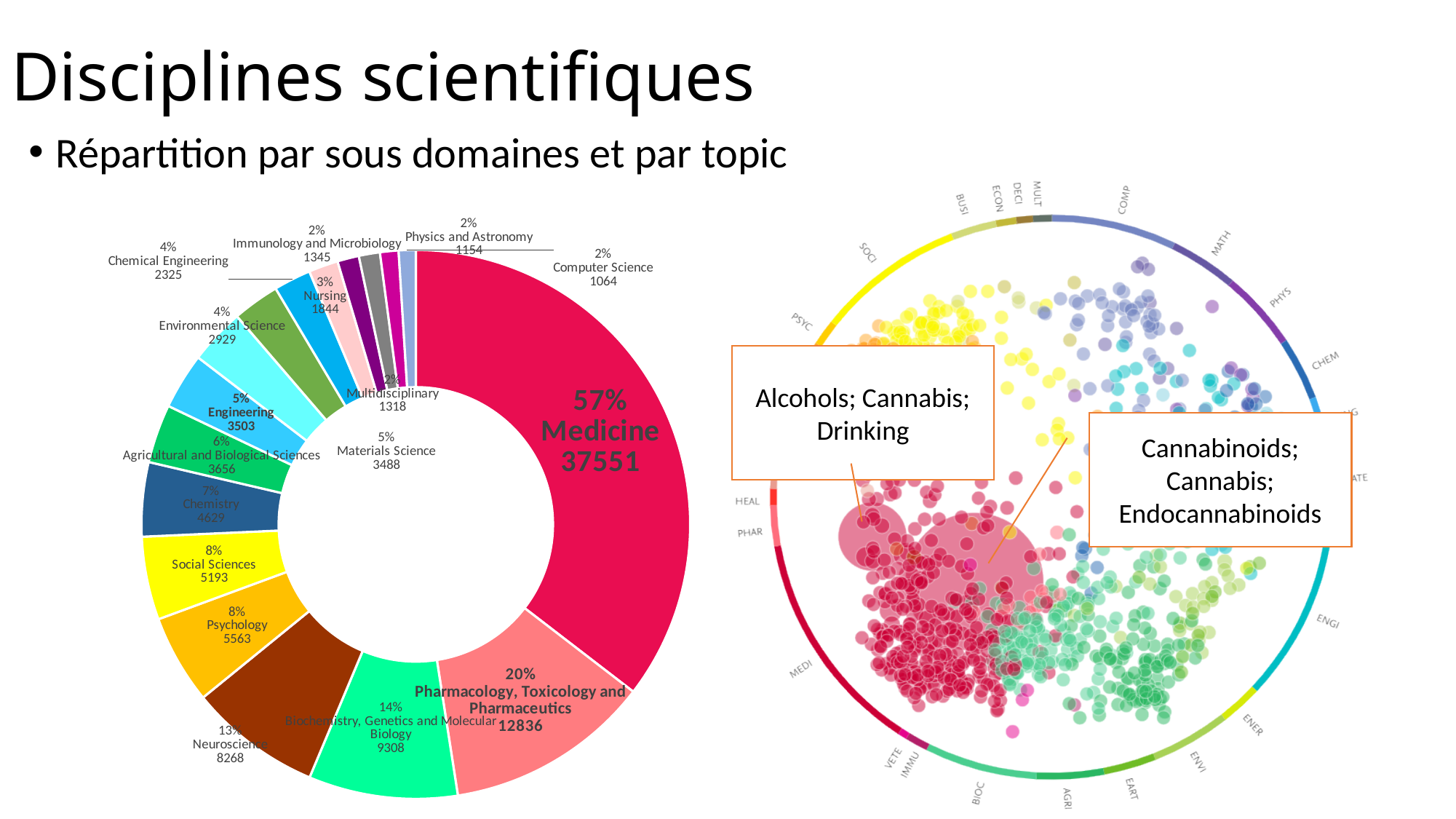
In the donut chart on the left, what percentage share does Pharmacology, Toxicology and Pharmaceutics have? 20% In the donut chart on the left, what is the value for Medicine? 37551 What kind of chart is shown on the left of the slide? Donut (pie) chart In the donut chart on the left, which labelled discipline has the smallest value? Computer Science In the donut chart on the left, what is the difference between the values for Psychology and Social Sciences? 370 In the donut chart on the left, which discipline has the largest share? Medicine In the donut chart on the left, what is the value for Neuroscience? 8268 In the donut chart on the left, what percentage share does Chemistry have? 7% In the donut chart on the left, what is the value for Chemical Engineering? 2325 In the donut chart on the left, which is larger: Biochemistry, Genetics and Molecular Biology or Neuroscience? Biochemistry, Genetics and Molecular Biology In the donut chart on the left, what is the value for Nursing? 1844 In the donut chart on the left, what is the difference between the values for Medicine and Pharmacology, Toxicology and Pharmaceutics? 24715